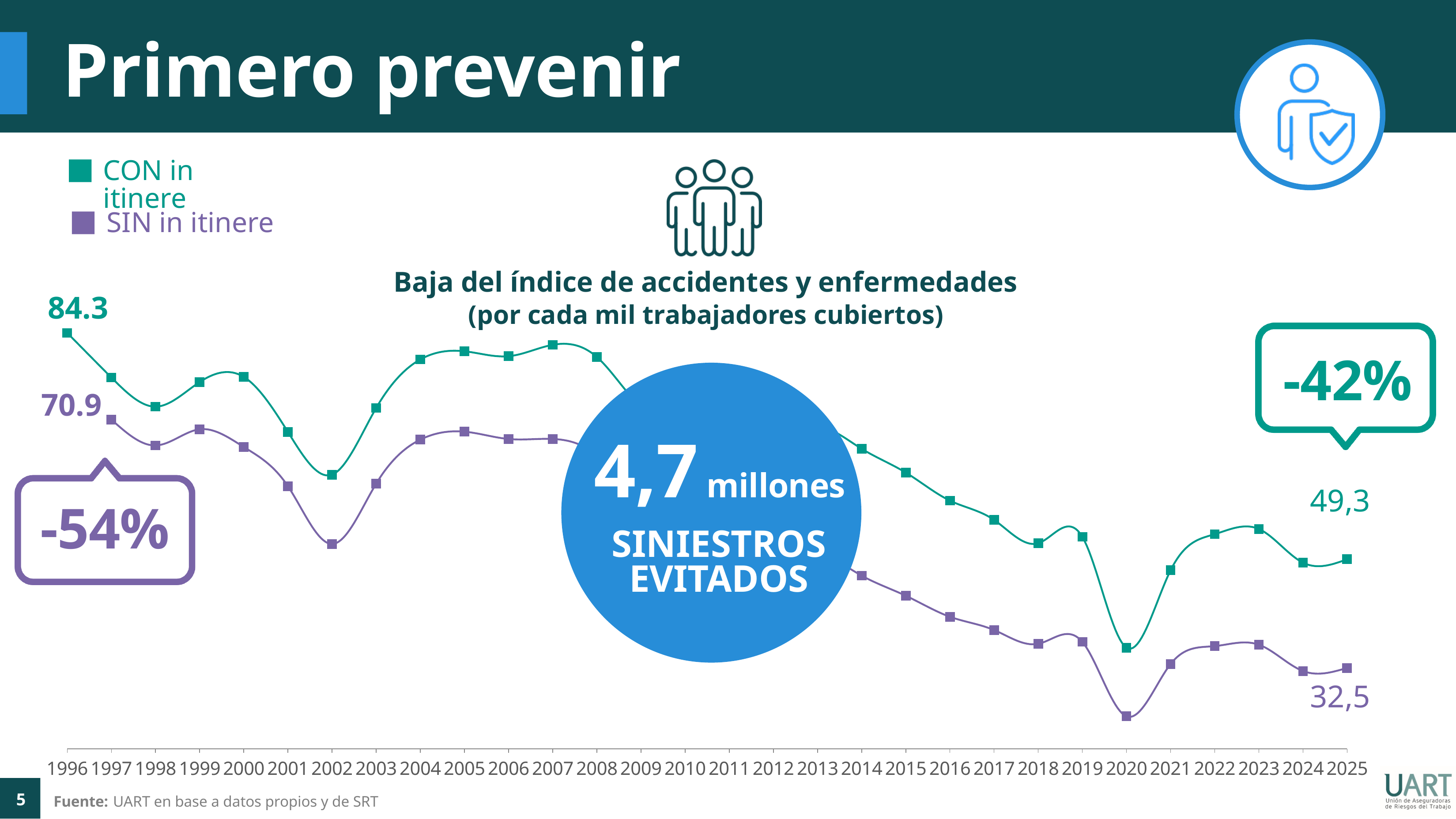
How many series does the legend list? 2 What kind of chart is shown on the slide? line chart In which year is the CON in itinere series at its highest? 1996 What is the difference between the CON in itinere and SIN in itinere values in 2025? 16,8 What is the value for SIN in itinere in 2025? 32,5 What is the value for CON in itinere in 1996? 84.3 How many years are shown on the x axis? 30 Does the CON in itinere series rise or fall overall from 1996 to 2025? fall In which year is the SIN in itinere series at its lowest? 2020 What is the value for CON in itinere in 2025? 49,3